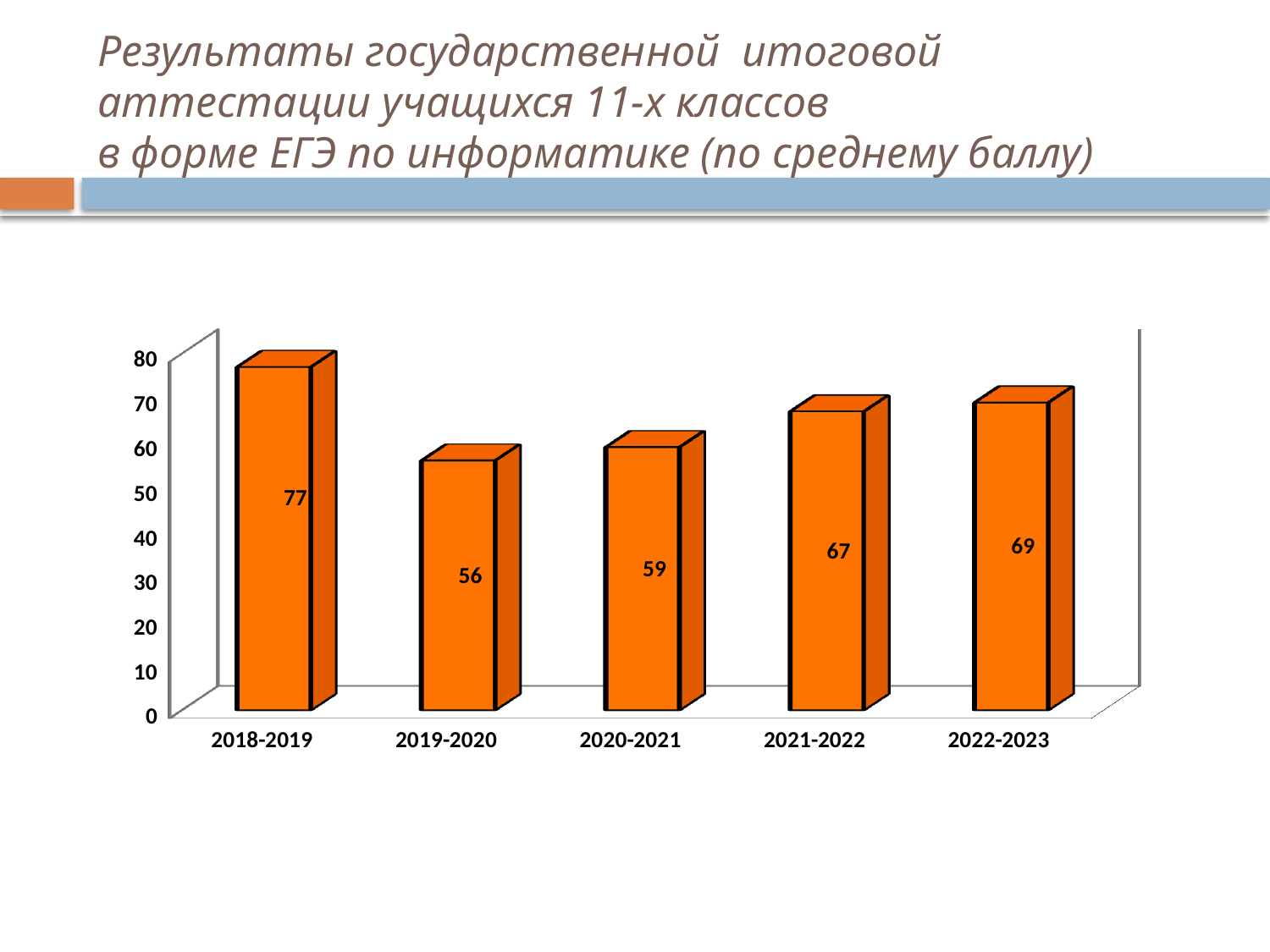
Which year has the lowest value? 2019-2020 Which year has the highest value? 2018-2019 Which is larger, the value for 2020-2021 or the value for 2021-2022? 2021-2022 What is the value for 2021-2022? 67 Is the value for 2022-2023 greater or less than 60? greater What is the difference between the values for 2018-2019 and 2019-2020? 21 How many categories are shown on the x axis? 5 What kind of chart is shown on the slide? bar chart Do the values rise or fall from 2019-2020 to 2022-2023? rise What is the difference between the values for 2022-2023 and 2020-2021? 10 What is the value for 2019-2020? 56 What is the value for 2018-2019? 77